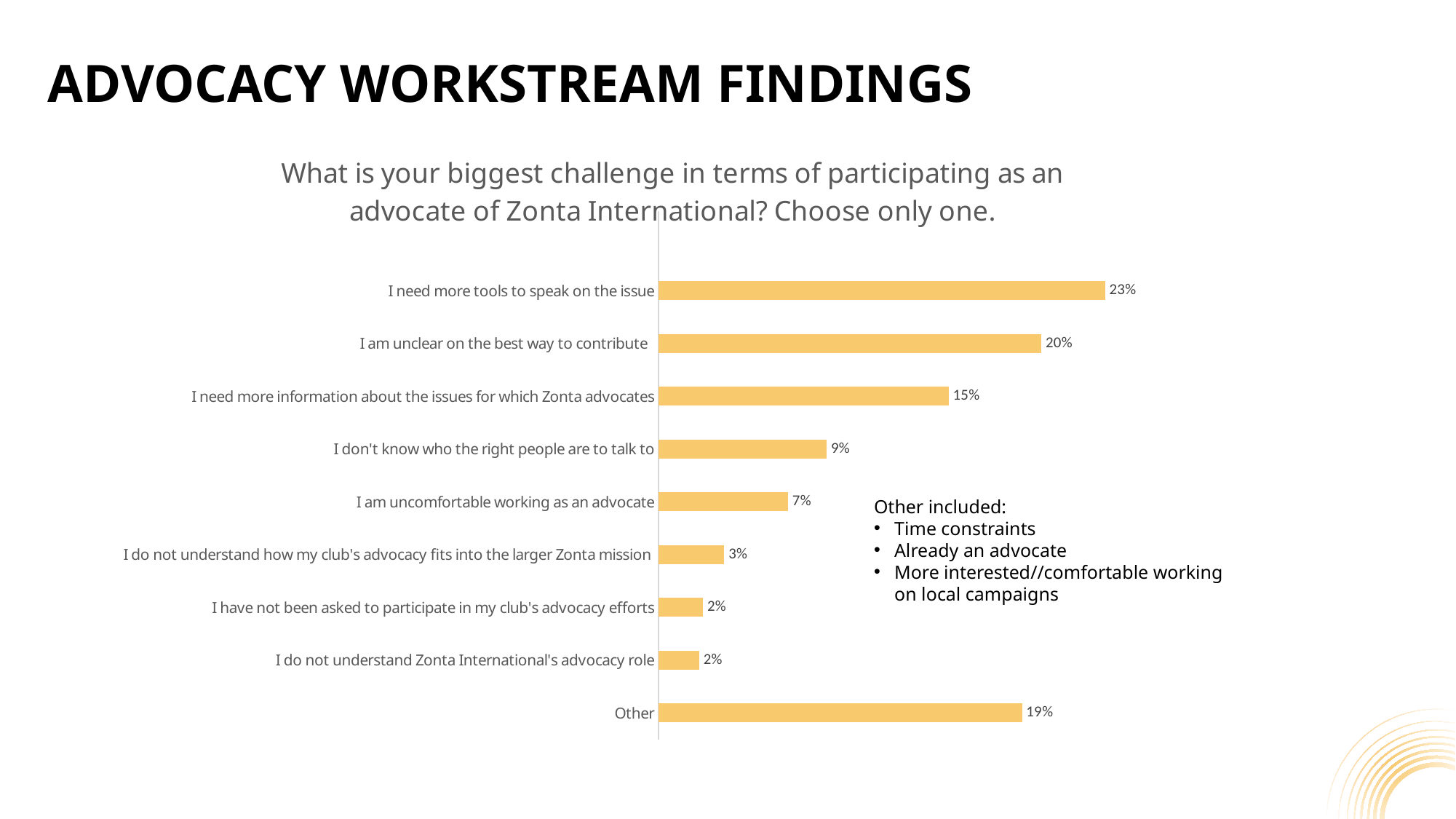
What kind of chart is shown on the slide? Bar chart What is the difference between "I am uncomfortable working as an advocate" and "I do not understand how my club's advocacy fits into the larger Zonta mission"? 4% What is the lowest percentage shown on the chart? 2% How many categories are shown on the chart? 9 What is the difference between "I need more tools to speak on the issue" and "I am unclear on the best way to contribute"? 3% What is the title of the chart? What is your biggest challenge in terms of participating as an advocate of Zonta International? Choose only one. What value is shown for "I am unclear on the best way to contribute"? 20% What percentage is shown for "Other"? 19% What value is shown for "I don't know who the right people are to talk to"? 9% Which challenge has the highest percentage? I need more tools to speak on the issue What percentage of respondents chose "I need more tools to speak on the issue" as their biggest challenge? 23% Which is larger: "I need more information about the issues for which Zonta advocates" or "I am uncomfortable working as an advocate"? I need more information about the issues for which Zonta advocates